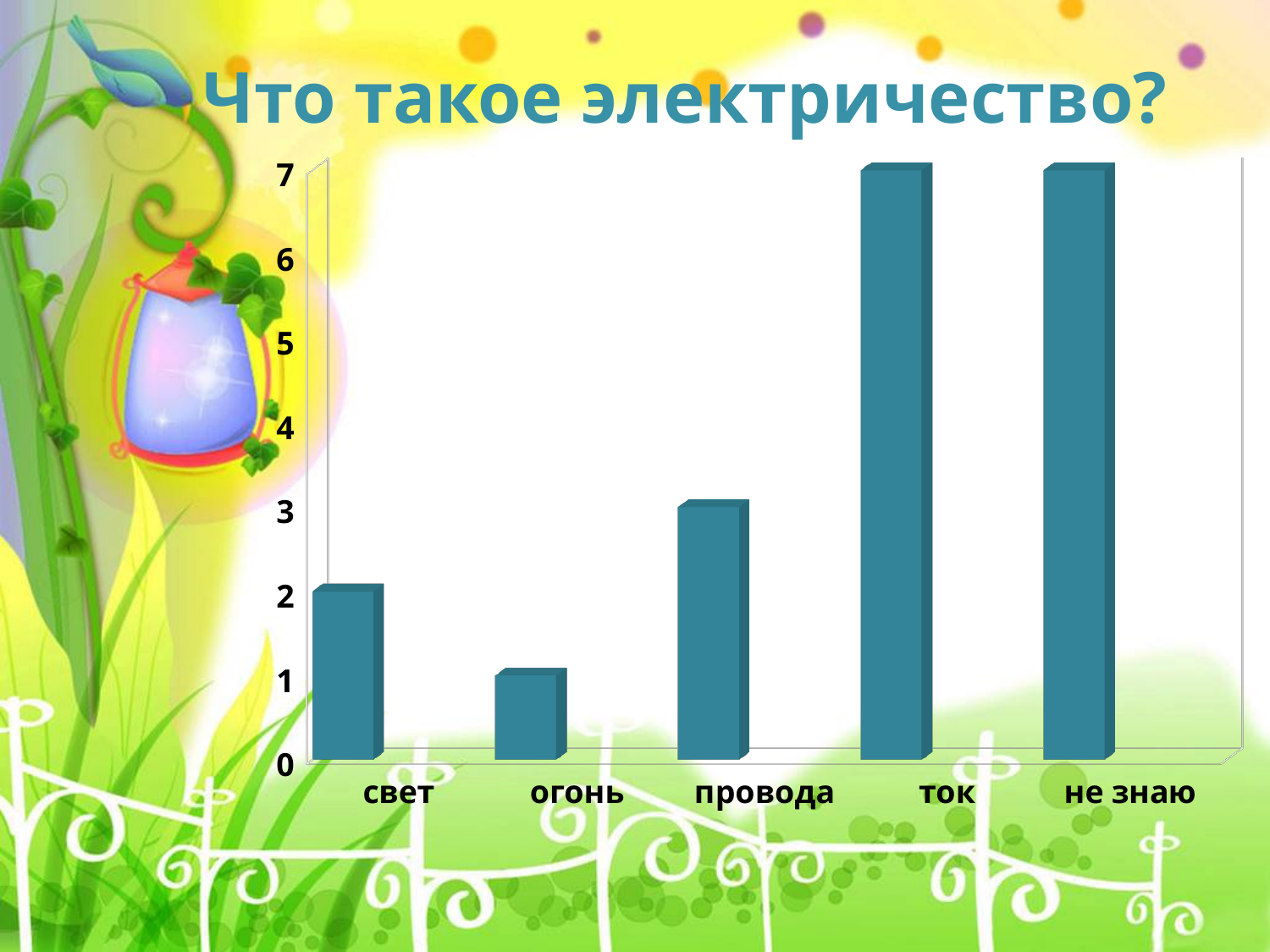
Is the value for не знаю greater or less than 5? greater What is the difference between the values for провода and свет? 1 Which is larger, the value for провода or the value for огонь? провода What is the value for огонь? 1 What is the highest value shown on the vertical axis? 7 What is the title of the chart? Что такое электричество? What kind of chart is shown on the slide? bar chart Which category has the lowest value? огонь What is the value for провода? 3 How many categories are shown on the x axis? 5 What is the value for ток? 7 What is the value for свет? 2